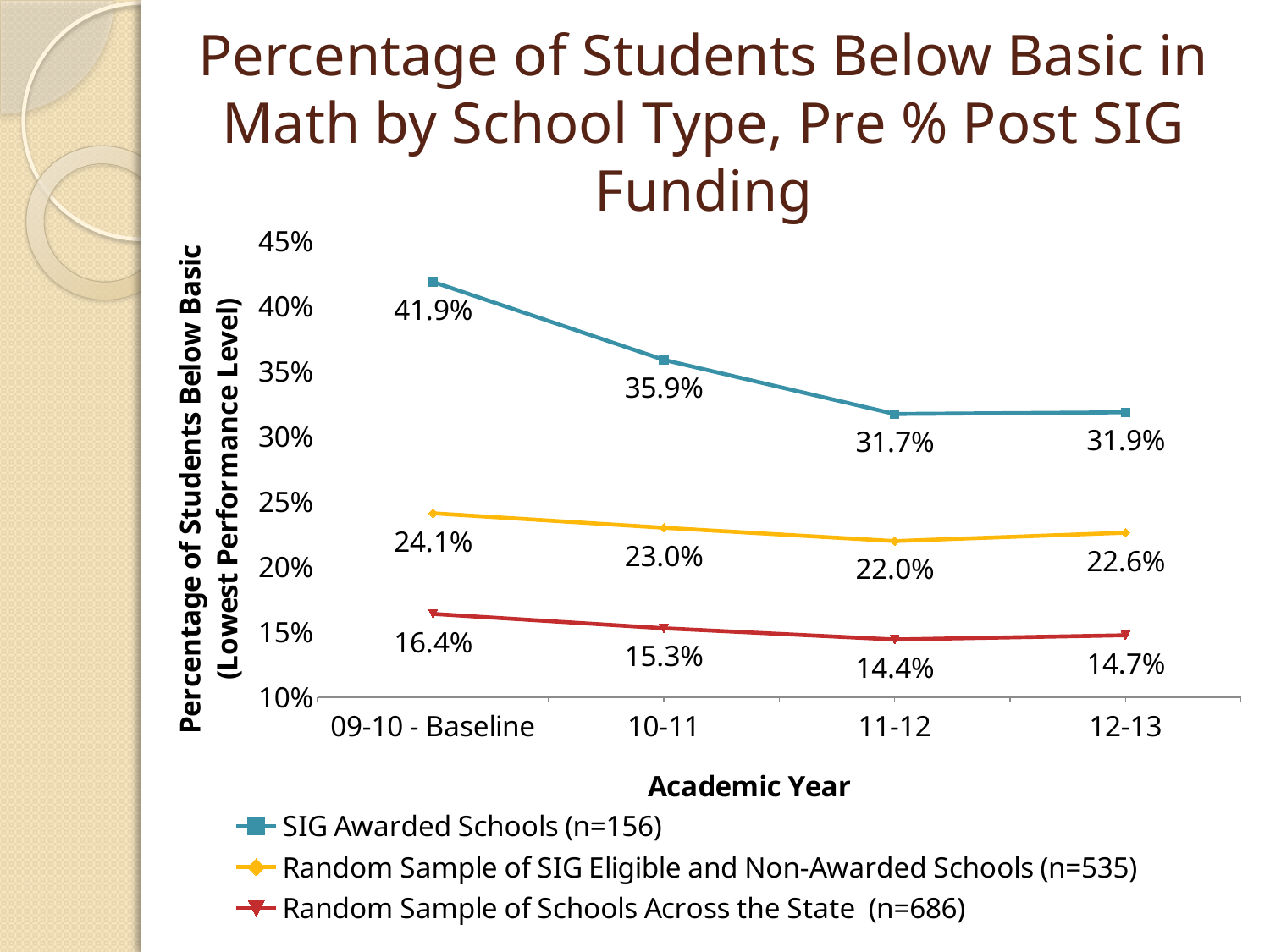
In which academic year is the value for Random Sample of Schools Across the State highest? 09-10 - Baseline In which academic year is the value for SIG Awarded Schools lowest? 11-12 Does the value for SIG Awarded Schools rise or fall from 09-10 - Baseline to 11-12? Fall What kind of chart is shown on the slide? Line chart What is the value for Random Sample of SIG Eligible and Non-Awarded Schools in 11-12? 22.0% What is the value for Random Sample of Schools Across the State in 12-13? 14.7% What is the difference between the SIG Awarded Schools values in 09-10 - Baseline and 12-13? 10.0% How many series does the legend list? 3 Is the value for SIG Awarded Schools in 10-11 greater or less than 35%? greater What is the value for SIG Awarded Schools in 09-10 - Baseline? 41.9% Which is larger in 10-11: the value for SIG Awarded Schools or the value for Random Sample of SIG Eligible and Non-Awarded Schools? SIG Awarded Schools How many academic years are shown on the x axis? 4